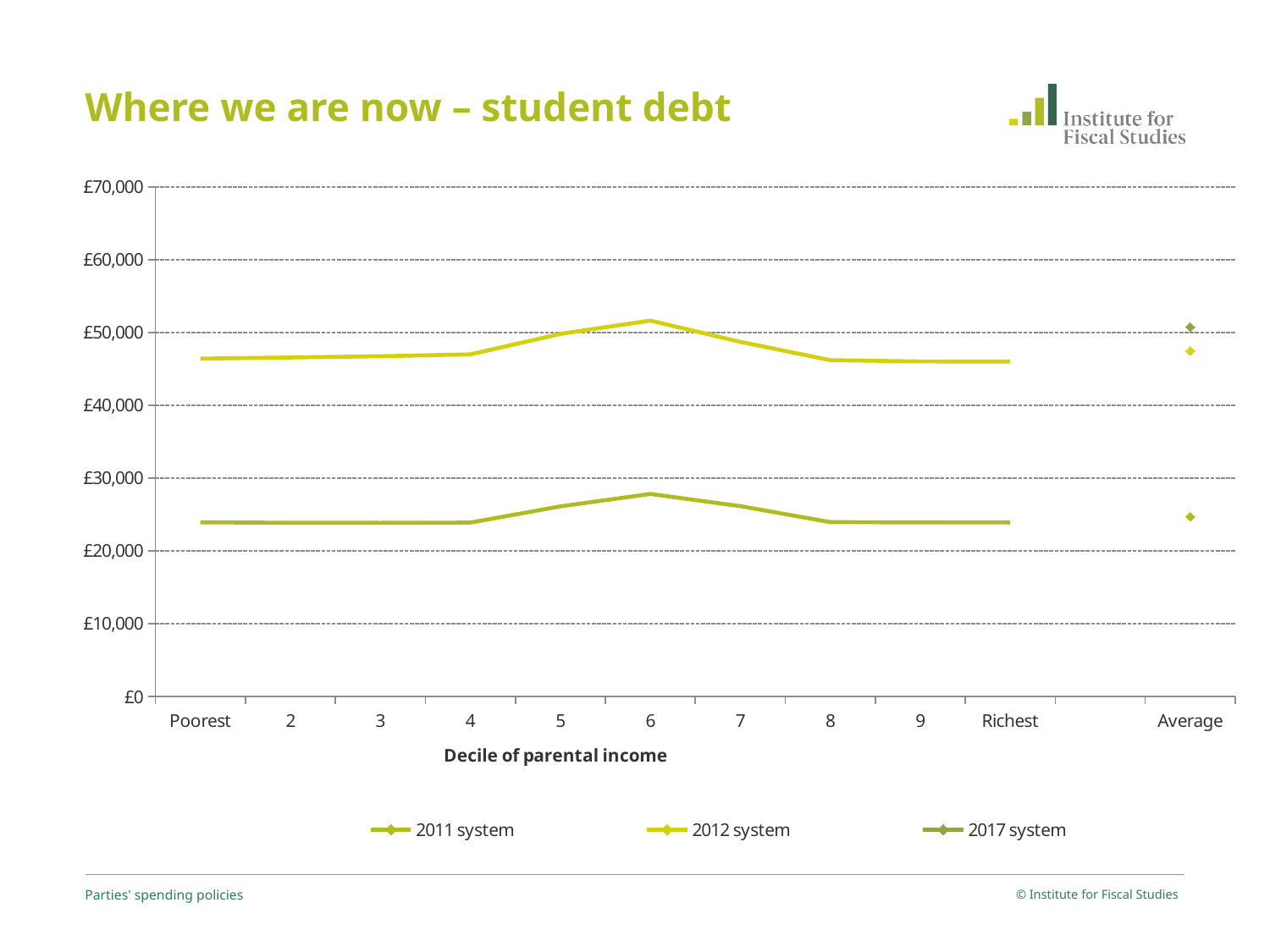
What kind of chart is shown on the slide? line chart Is the value for the 2012 system at decile 6 greater or less than £50,000? greater At which decile does the 2011 system line reach its highest value? 6 Is the value for the 2012 system at the Poorest decile greater or less than £40,000? greater How many categories are shown along the x axis, including Average? 11 How many series does the legend list? 3 Is the value for the 2011 system at the Richest decile greater or less than £30,000? less At which decile does the 2012 system line reach its highest value? 6 Which series are listed in the legend? 2011 system, 2012 system, 2017 system What is the label of the x axis? Decile of parental income Which series has the highest Average value? 2017 system Which series has the larger value at the Poorest decile, the 2011 system or the 2012 system? 2012 system